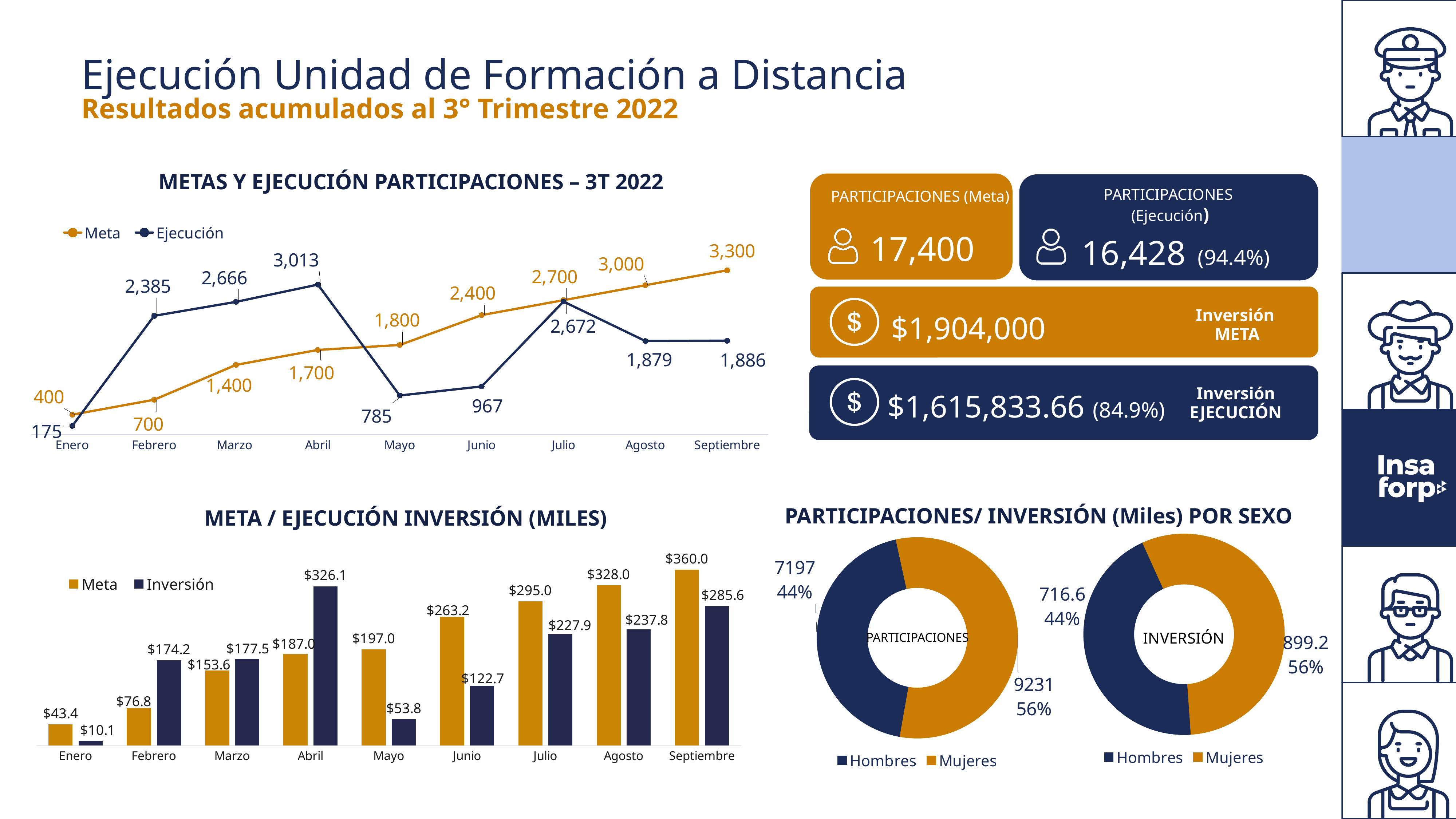
In the chart 'METAS Y EJECUCIÓN PARTICIPACIONES – 3T 2022', what is the difference between the Meta and Ejecución values for Septiembre? 1,414 In the PARTICIPACIONES donut chart, what share of the total is Mujeres? 56% In the chart 'METAS Y EJECUCIÓN PARTICIPACIONES – 3T 2022', does the Meta series rise or fall from Enero to Septiembre? rises How many series does the legend of the chart 'METAS Y EJECUCIÓN PARTICIPACIONES – 3T 2022' list? 2 In the chart 'METAS Y EJECUCIÓN PARTICIPACIONES – 3T 2022', how many months are shown on the x axis? 9 In the chart 'METAS Y EJECUCIÓN PARTICIPACIONES – 3T 2022', which month has the highest Ejecución value? Abril What kind of chart is 'META / EJECUCIÓN INVERSIÓN (MILES)'? bar chart In the chart 'META / EJECUCIÓN INVERSIÓN (MILES)', what is the Inversión value for Mayo? $53.8 In the chart 'META / EJECUCIÓN INVERSIÓN (MILES)', which month has the lowest Meta value? Enero In the chart 'METAS Y EJECUCIÓN PARTICIPACIONES – 3T 2022', what is the Ejecución value for Abril? 3,013 In the chart 'META / EJECUCIÓN INVERSIÓN (MILES)', which is larger for Febrero, Meta or Inversión? Inversión In the chart 'META / EJECUCIÓN INVERSIÓN (MILES)', which month has the highest Inversión value? Abril